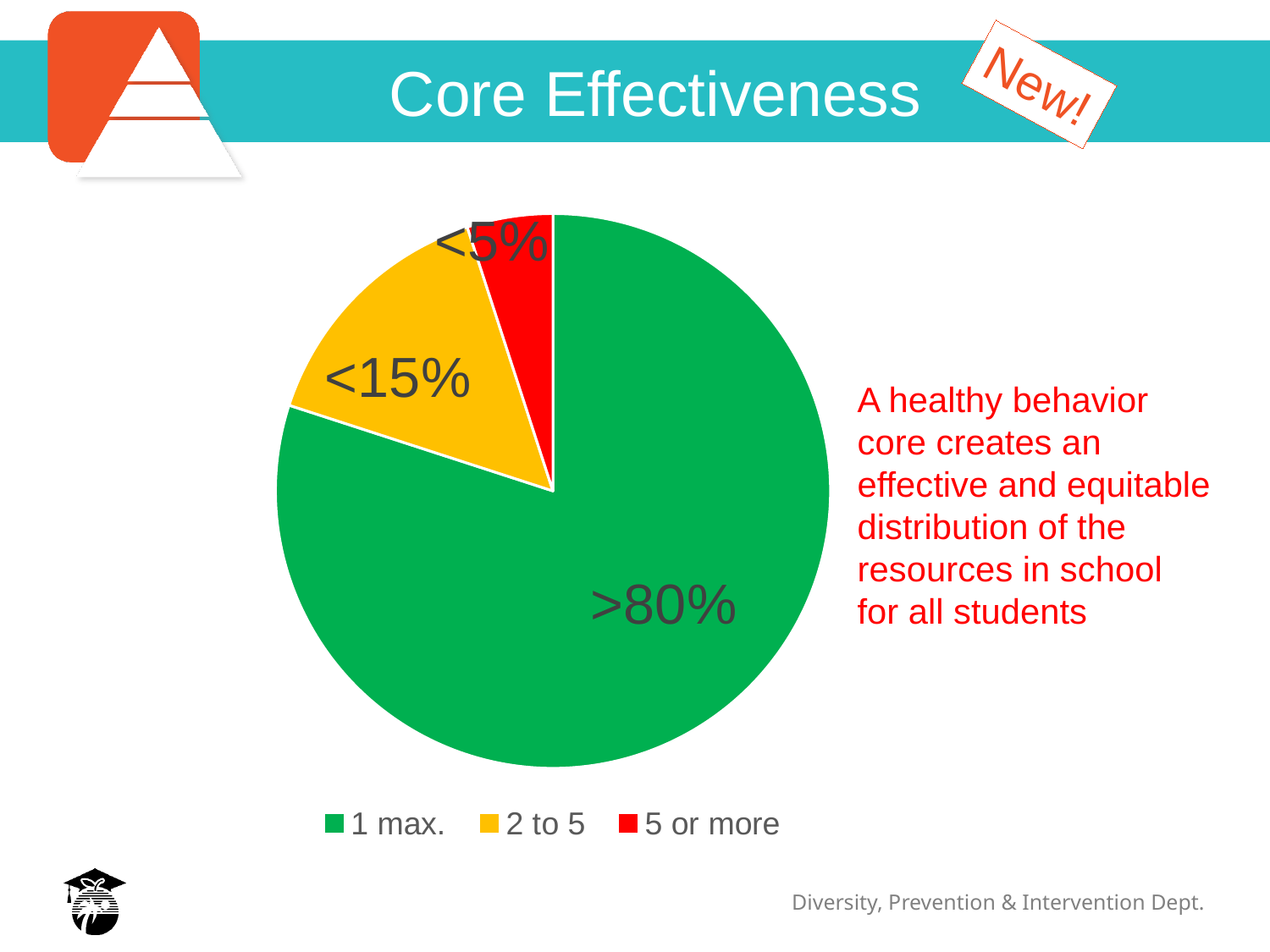
What kind of chart is shown on the slide? pie chart What label is printed on the '2 to 5' slice of the pie chart? <15% What colour is the '5 or more' slice in the pie chart? red Which category has the largest slice in the pie chart? 1 max. Which category has the smallest slice in the pie chart? 5 or more How many entries does the legend of the pie chart list? 3 What is the title of the slide containing the pie chart? Core Effectiveness How many slices does the pie chart have? 3 What label is printed on the '1 max.' slice of the pie chart? >80% Which slice is larger in the pie chart, '1 max.' or '2 to 5'? 1 max. What label is printed on the '5 or more' slice of the pie chart? <5% Which slice is larger in the pie chart, '2 to 5' or '5 or more'? 2 to 5